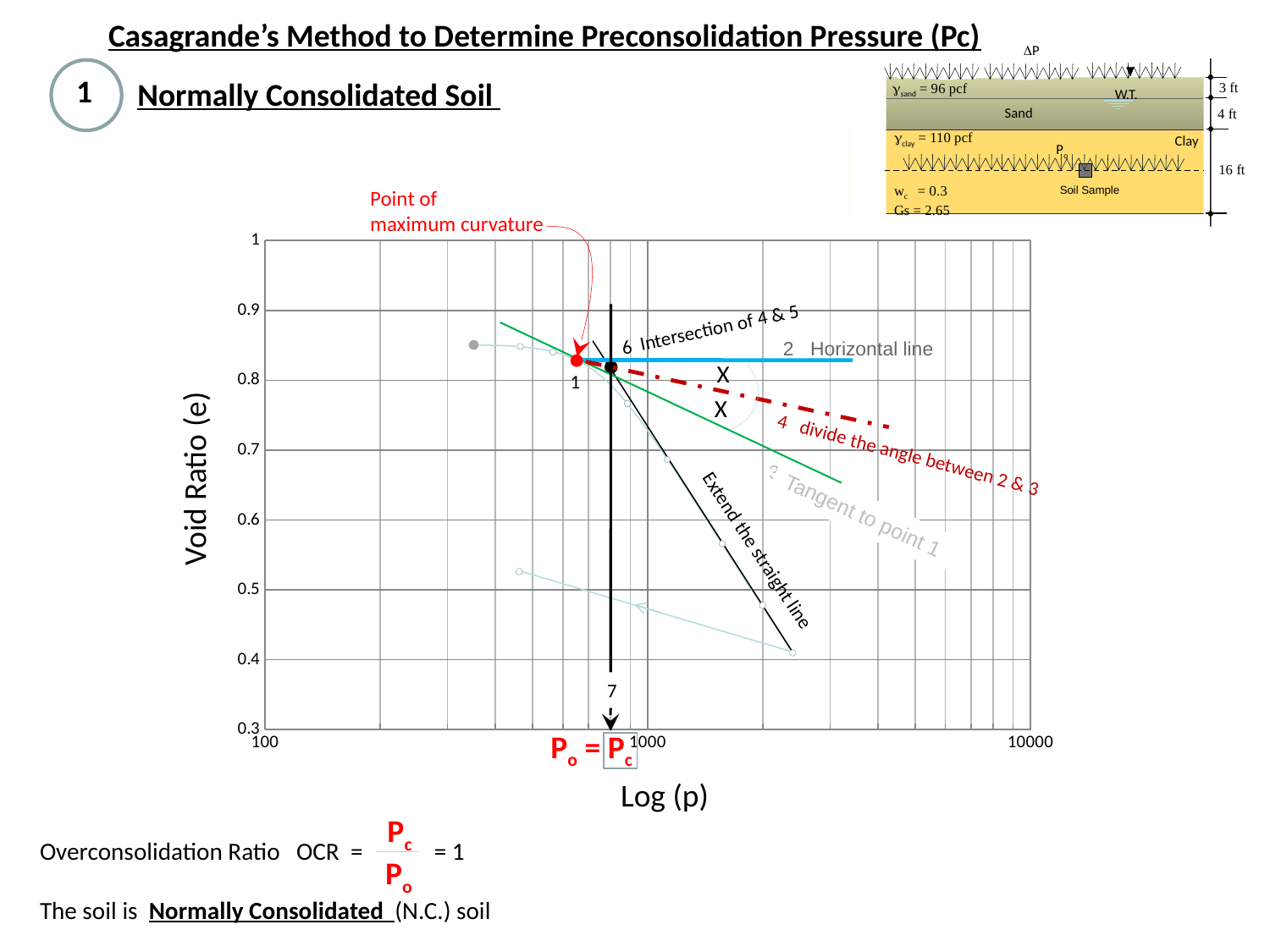
As Log (p) increases along the x axis, does the void ratio rise or fall? fall What is the label of the vertical axis of the chart? Void Ratio (e) What is the lowest value shown on the vertical axis of the chart? 0.3 Is the void ratio at the point of maximum curvature greater or less than 0.9? less What kind of chart is shown on the slide? line chart What is the label of the horizontal axis of the chart? Log (p) Is the void ratio of the leftmost data point on the curve greater or less than 0.8? greater Is the void ratio of the lowest data point on the curve greater or less than 0.5? less